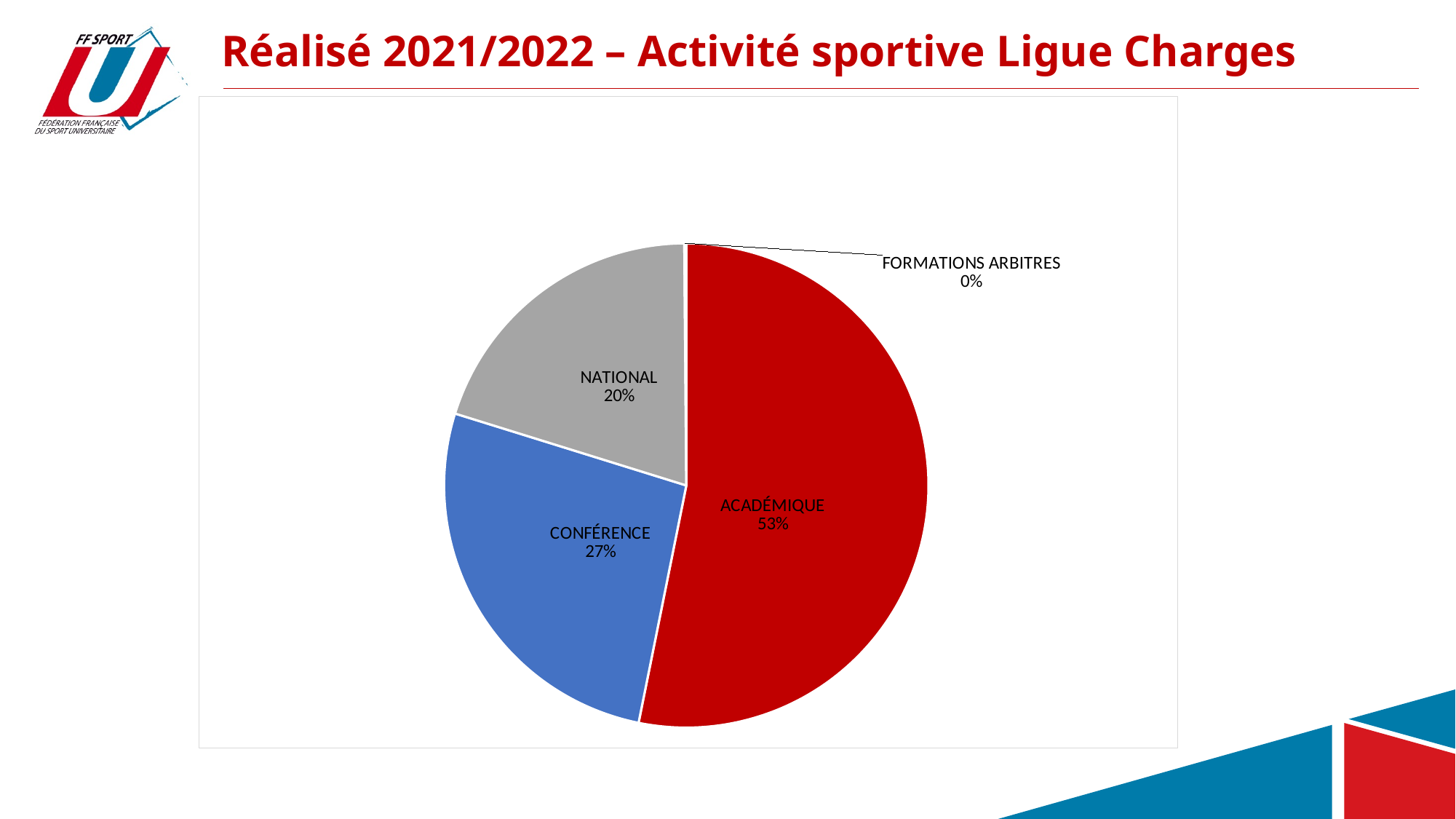
What share of the pie does NATIONAL represent? 20% What is the difference in percentage points between ACADÉMIQUE and CONFÉRENCE? 26 What percentage is shown for FORMATIONS ARBITRES? 0% Which category has the smallest slice of the pie? FORMATIONS ARBITRES What colour is the ACADÉMIQUE slice? red How many categories are shown in the pie chart? 4 What share of the pie does ACADÉMIQUE represent? 53% Which is larger, the share for CONFÉRENCE or the share for NATIONAL? CONFÉRENCE What type of chart is shown on the slide? pie chart What is the difference in percentage points between CONFÉRENCE and NATIONAL? 7 Which category has the largest slice of the pie? ACADÉMIQUE What share of the pie does CONFÉRENCE represent? 27%